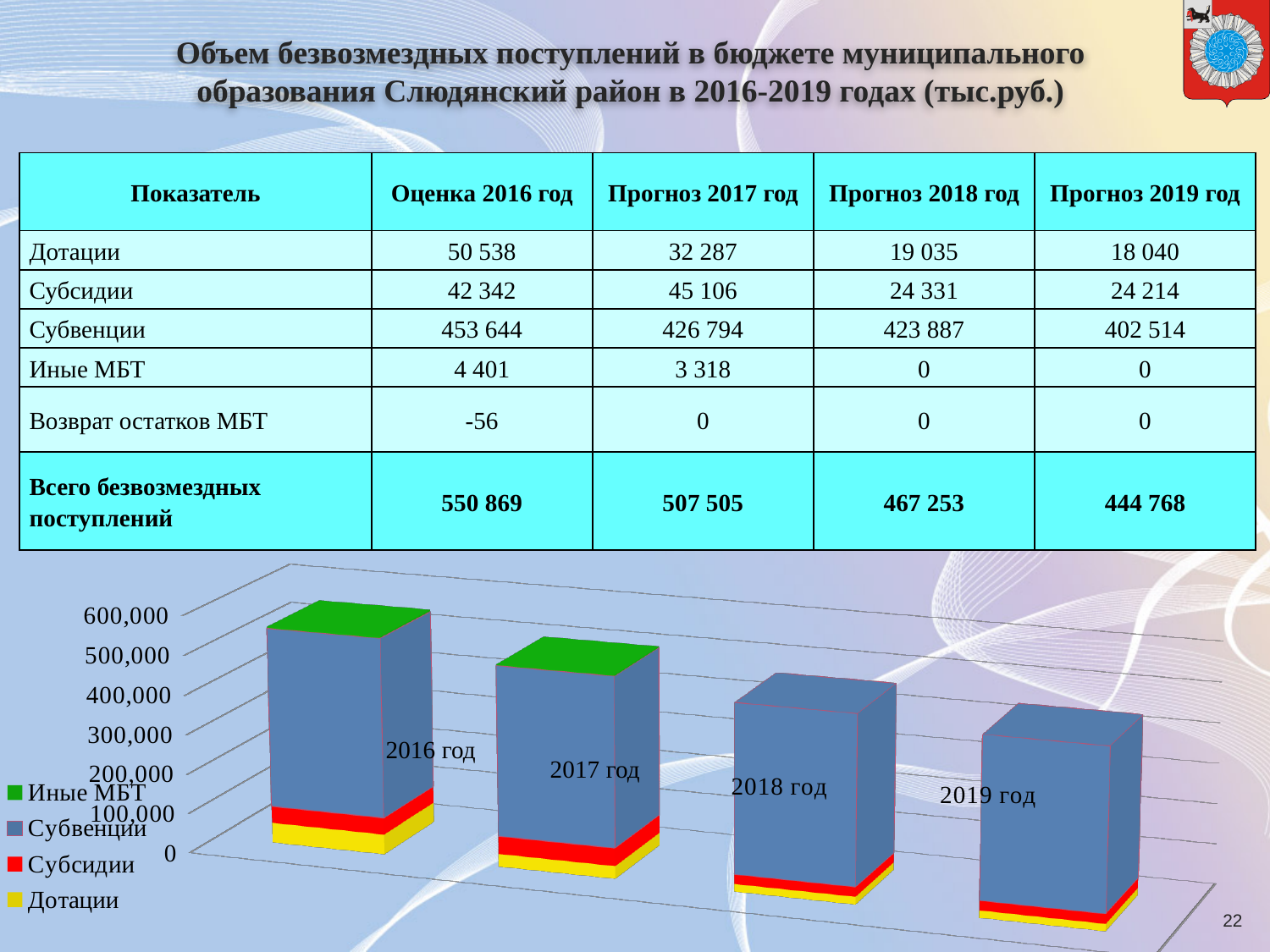
What kind of chart is shown at the bottom of the slide? stacked bar chart Which is larger in the chart: the stacked bar for 2016 год or for 2019 год? 2016 год Which legend entry is shown in green in the chart? Иные МБТ Is the total for 2016 год in the chart greater or less than 500,000? greater Which year has the shortest stacked bar in the chart? 2019 год According to the table on the slide, what is the total of the 2016 stacked bar (Всего безвозмездных поступлений, Оценка 2016 год)? 550 869 Do the stacked bar totals rise or fall from 2016 to 2019? fall How many series does the chart legend list? 4 Which series forms the bottom (yellow) segment of each stacked bar? Дотации Which year has the tallest stacked bar in the chart? 2016 год How many years (bars) are plotted in the chart? 4 Is the total for 2019 год in the chart greater or less than 500,000? less